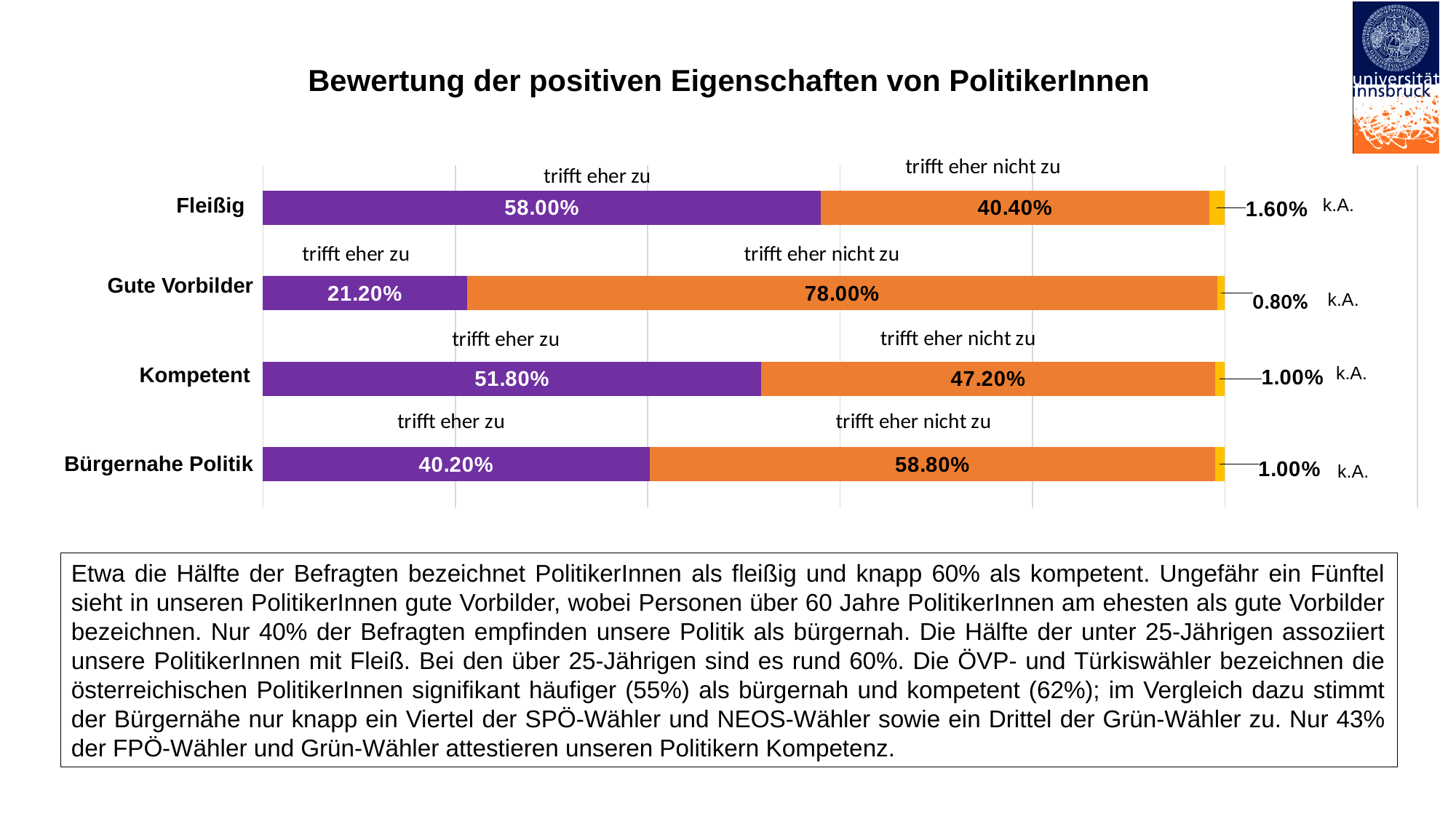
How many response options (series) are shown for each category? 3 How many categories are shown in the chart? 4 What kind of chart is shown on the slide? Stacked bar chart What is the "trifft eher zu" value for Bürgernahe Politik? 40.20% What is the title of the chart? Bewertung der positiven Eigenschaften von PolitikerInnen What is the k.A. value for Fleißig? 1.60% What is the difference between the "trifft eher zu" and "trifft eher nicht zu" values for Kompetent? 4.60% What is the "trifft eher nicht zu" value for Gute Vorbilder? 78.00% Is the "trifft eher nicht zu" value larger for Gute Vorbilder or for Bürgernahe Politik? Gute Vorbilder Which category has the highest "trifft eher zu" value? Fleißig What percentage of respondents said "trifft eher zu" for Fleißig? 58.00% Which category has the lowest "trifft eher zu" value? Gute Vorbilder